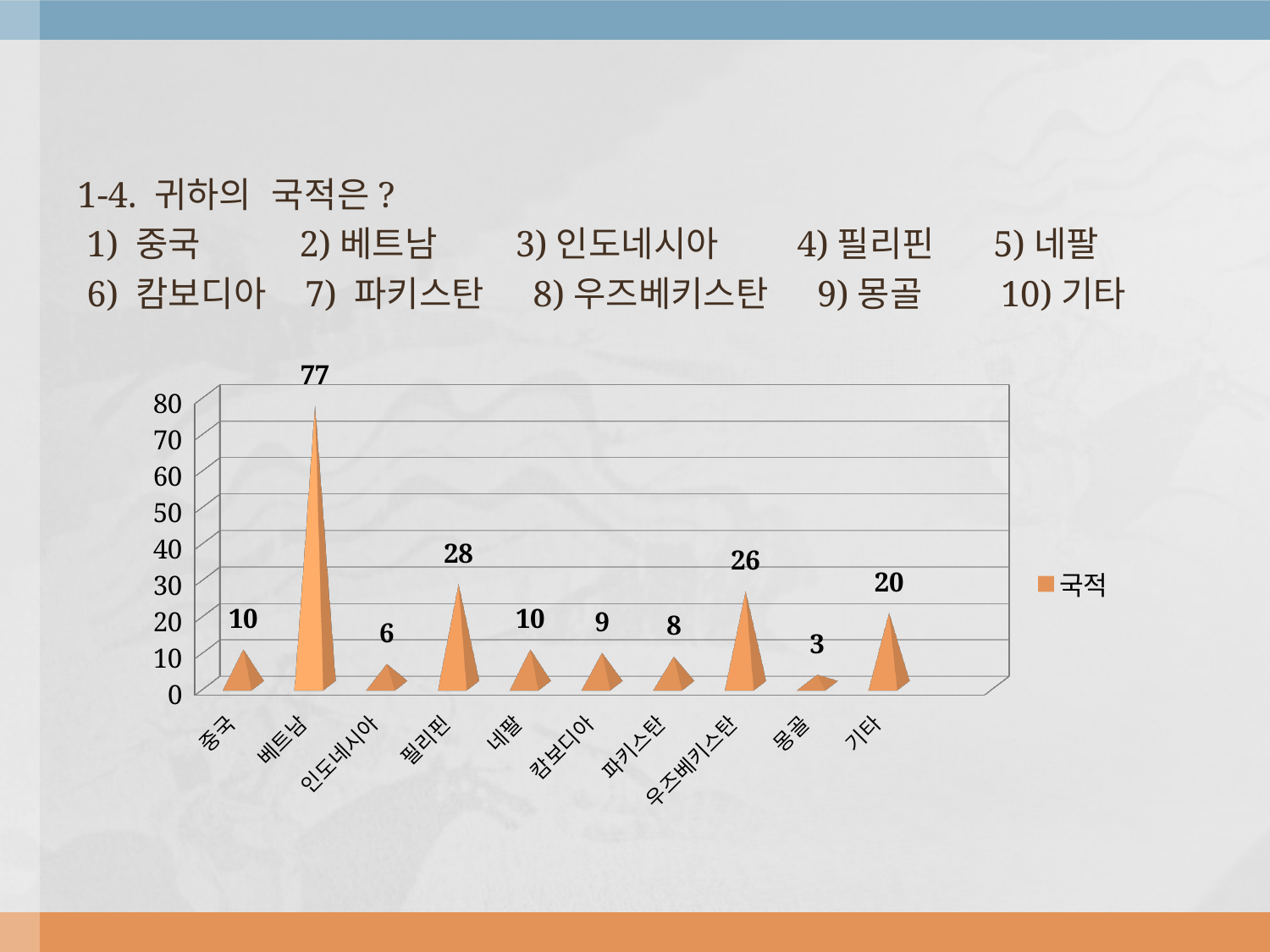
What is the value for 우즈베키스탄? 26 Which is larger, the value for 중국 or the value for 인도네시아? 중국 Is the value for 베트남 greater or less than 70? greater What is the difference between the values for 베트남 and 필리핀? 49 What is the value for 베트남? 77 How many categories are shown on the x axis? 10 Which category has the highest value? 베트남 What kind of chart is shown on the slide? bar chart What is the difference between the values for 필리핀 and 우즈베키스탄? 2 Which category has the lowest value? 몽골 How many series does the legend list? 1 What is the value for 기타? 20